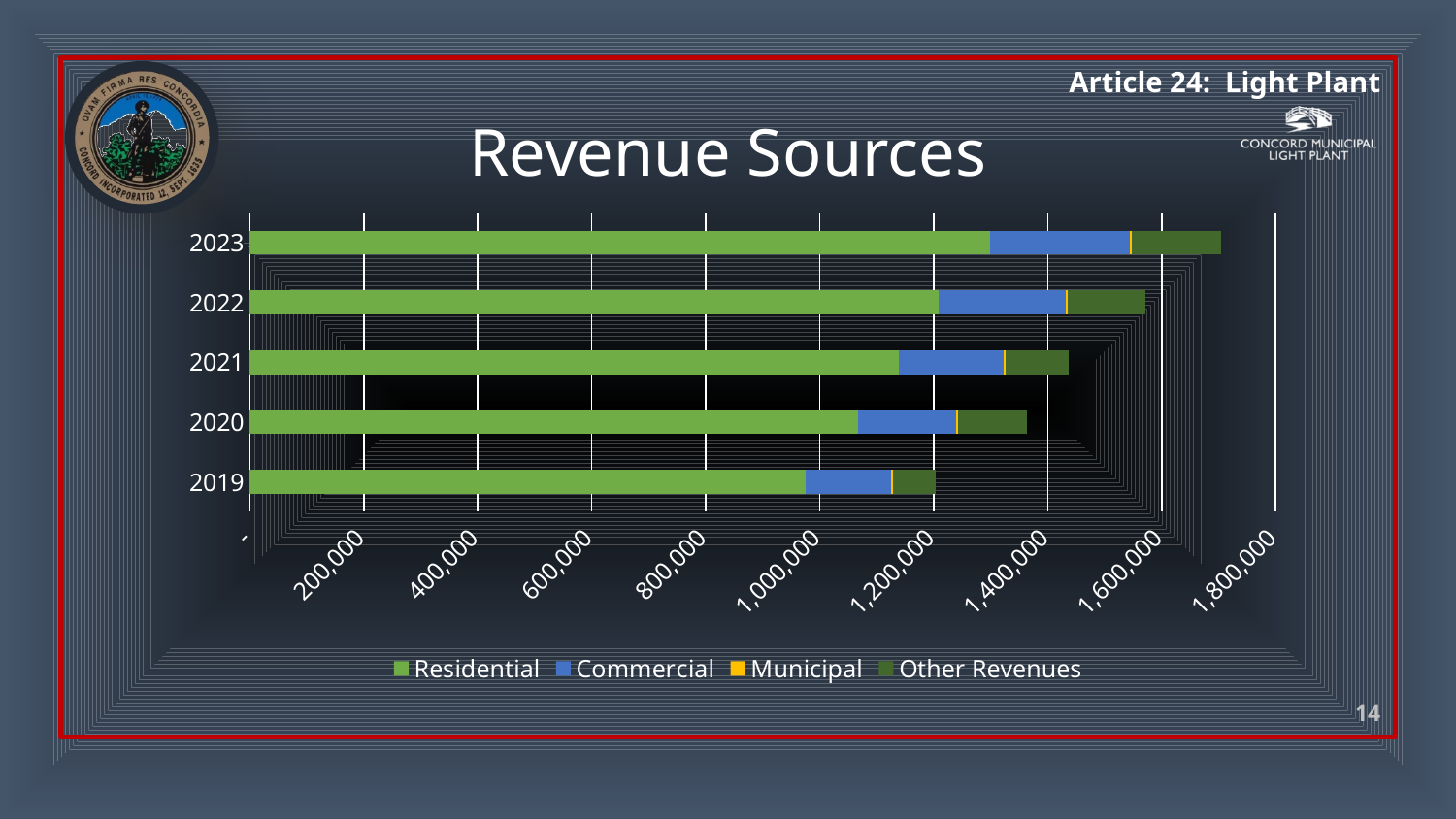
What is the title of the chart? Revenue Sources Is the total revenue bar for 2020 greater or less than 1,200,000? greater How many series does the legend list? 4 Do the total revenue bars rise or fall from 2019 to 2023? Rise Is the total revenue bar for 2023 greater or less than 1,600,000? greater Is the total revenue bar for 2019 greater or less than 1,400,000? less Which year has the lowest total revenue bar? 2019 What kind of chart is shown on the slide? Stacked bar chart Which has the larger total revenue bar, 2022 or 2021? 2022 How many years are shown on the chart? 5 Which year has the highest total revenue bar? 2023